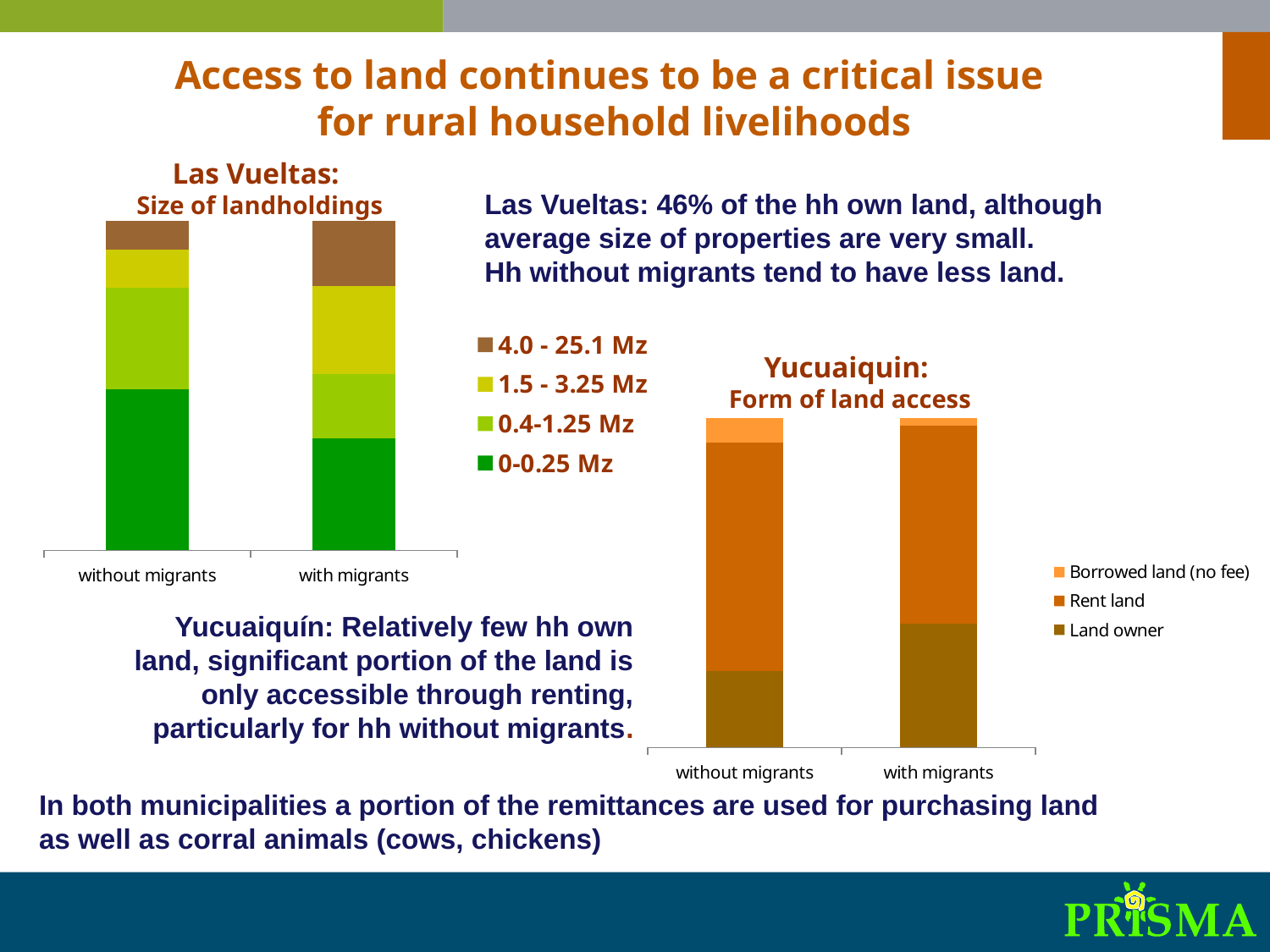
What are the two x-axis categories of the 'Las Vueltas: Size of landholdings' chart? without migrants, with migrants What are the legend entries of the 'Yucuaiquin: Form of land access' chart? Borrowed land (no fee), Rent land, Land owner What kind of chart is the 'Las Vueltas: Size of landholdings' chart? Stacked bar chart What kind of chart is the 'Yucuaiquin: Form of land access' chart? Stacked bar chart In the 'Yucuaiquin: Form of land access' chart, which category has the larger 'Rent land' segment, 'without migrants' or 'with migrants'? without migrants In the 'Las Vueltas: Size of landholdings' chart, which category has the larger '0-0.25 Mz' segment, 'without migrants' or 'with migrants'? without migrants How many categories are shown on the x axis of the 'Las Vueltas: Size of landholdings' chart? 2 How many categories are shown on the x axis of the 'Yucuaiquin: Form of land access' chart? 2 How many series does the legend of the 'Las Vueltas: Size of landholdings' chart list? 4 In the 'Las Vueltas: Size of landholdings' chart, which category has the larger '4.0 - 25.1 Mz' segment, 'without migrants' or 'with migrants'? with migrants How many series does the legend of the 'Yucuaiquin: Form of land access' chart list? 3